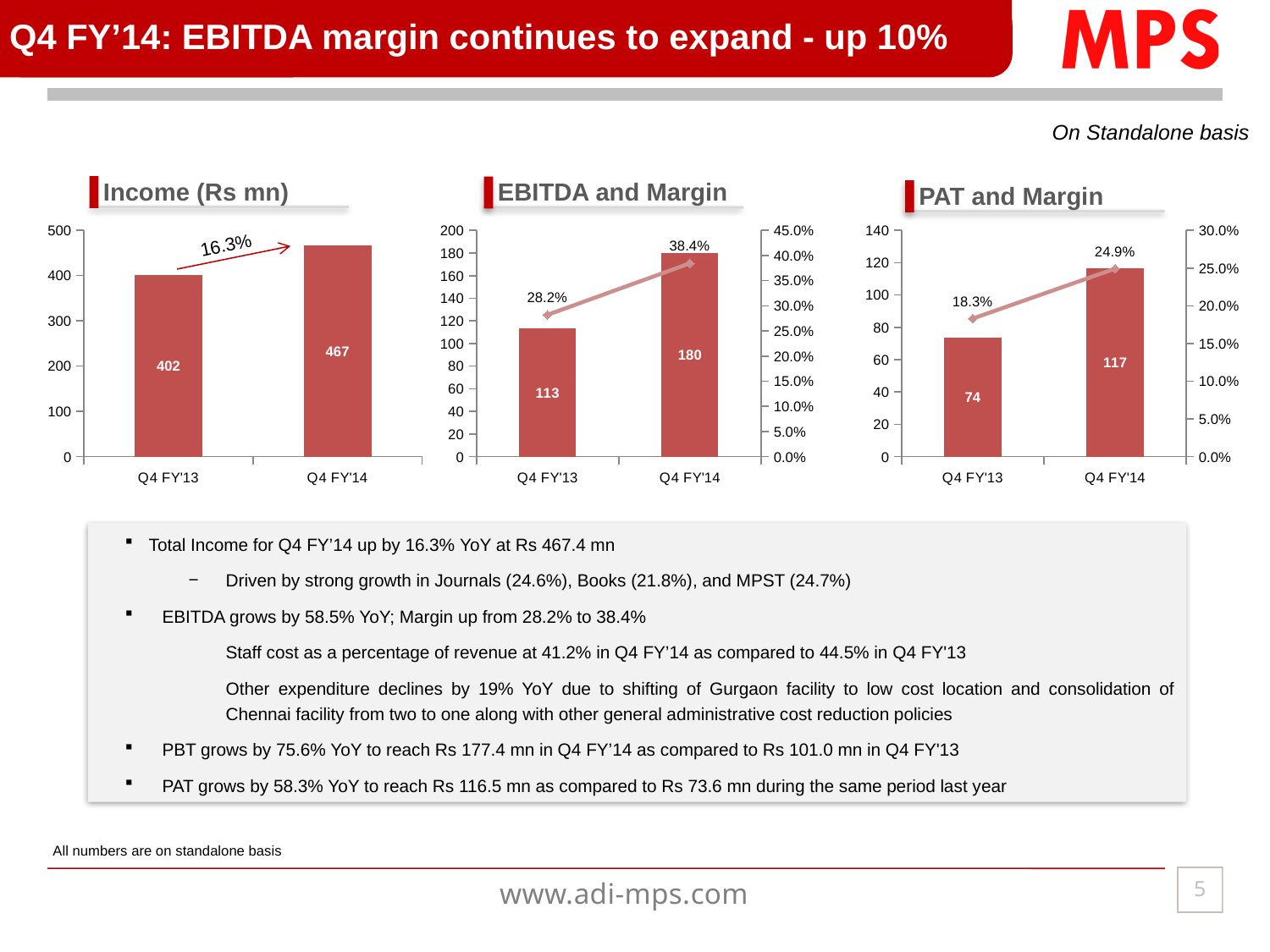
In the Income (Rs mn) chart, what is the value for Q4 FY'14? 467 In the Income (Rs mn) chart, what is the difference between the Q4 FY'14 and Q4 FY'13 values? 65 In the EBITDA and Margin chart, what is the difference in EBITDA between Q4 FY'14 and Q4 FY'13? 67 In the EBITDA and Margin chart, what is the EBITDA value for Q4 FY'13? 113 What kind of chart is the Income (Rs mn) chart? bar chart In the PAT and Margin chart, which period has the higher PAT, Q4 FY'13 or Q4 FY'14? Q4 FY'14 How many categories are shown on the x axis of the Income (Rs mn) chart? 2 In the PAT and Margin chart, does the margin rise or fall from Q4 FY'13 to Q4 FY'14? rise In the EBITDA and Margin chart, what is the margin for Q4 FY'14? 38.4% In the PAT and Margin chart, what is the margin for Q4 FY'13? 18.3% In the Income (Rs mn) chart, what is the value for Q4 FY'13? 402 In the PAT and Margin chart, what is the PAT value for Q4 FY'14? 117